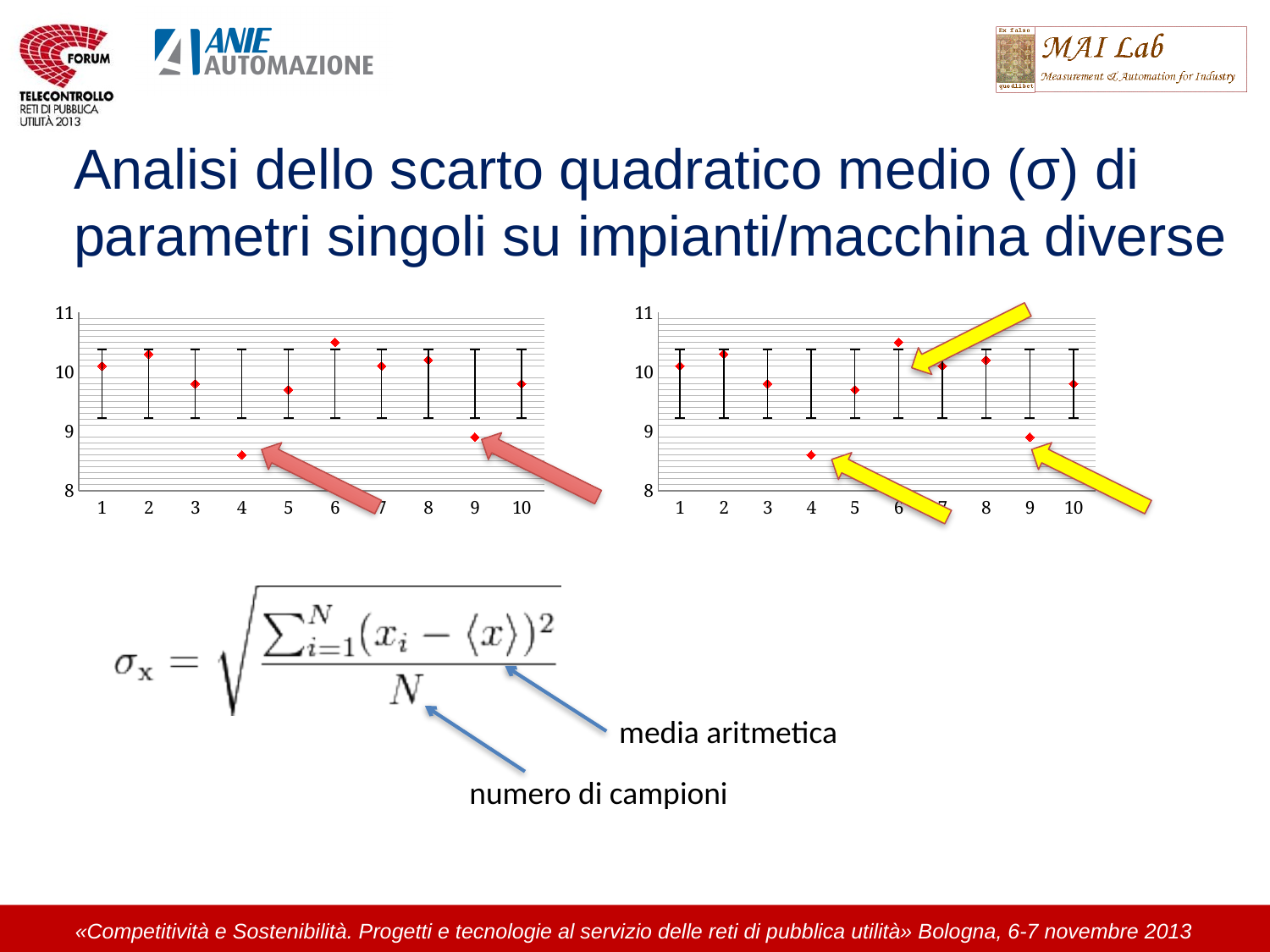
In the right chart, is the value for category 9 greater or less than 9? less In the right chart, which has the larger value, category 1 or category 4? 1 In the left chart, is the value for category 4 greater or less than 9? less In the left chart, how many data points are plotted along the x axis? 10 In the right chart, which x-axis category has the lowest plotted value? 4 What is the highest value shown on the y axis of the right chart? 11 What kind of chart is the left chart? scatter chart with error bars In the left chart, is the value for category 6 greater or less than 10? greater In the right chart, which has the larger value, category 6 or category 3? 6 In the left chart, which has the larger value, category 4 or category 9? 9